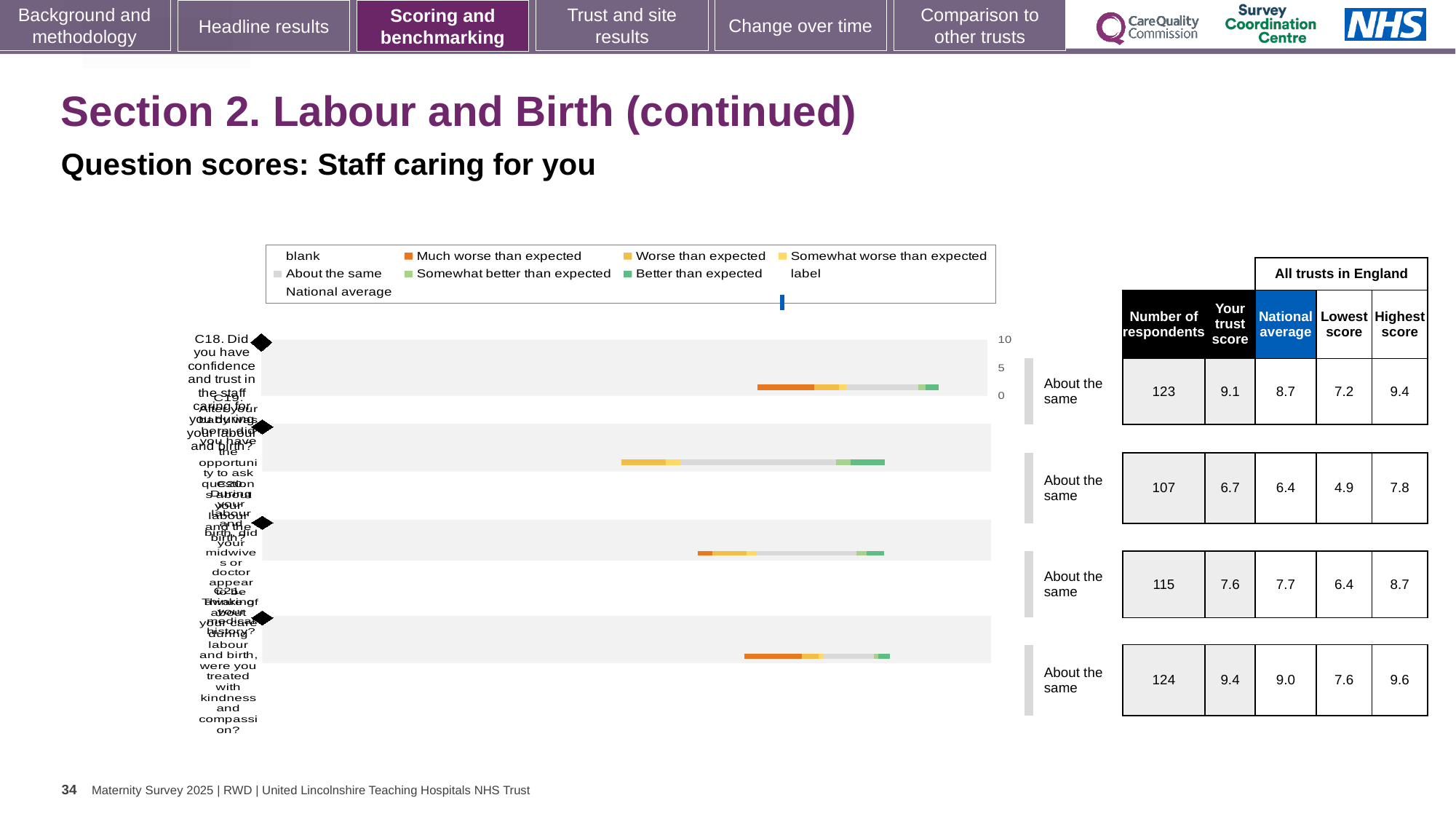
What colour does the legend use for 'Much worse than expected'? orange What kind of chart is used to show the question scores on this slide? bar chart How many questions (categories) are plotted in the chart? 4 Which question has the highest 'Your trust score'? C21 Which question has the lowest 'Your trust score'? C19 What is the 'Your trust score' for C18 (confidence and trust in the staff caring for you)? 9.1 What does the blue marker in the legend represent? National average What is the difference between the highest score and the lowest score for C21? 2.0 What benchmark category is shown for C18? About the same What is the national average score for C19? 6.4 How many respondents answered C21? 124 For C20, which is larger: the trust score or the national average? national average